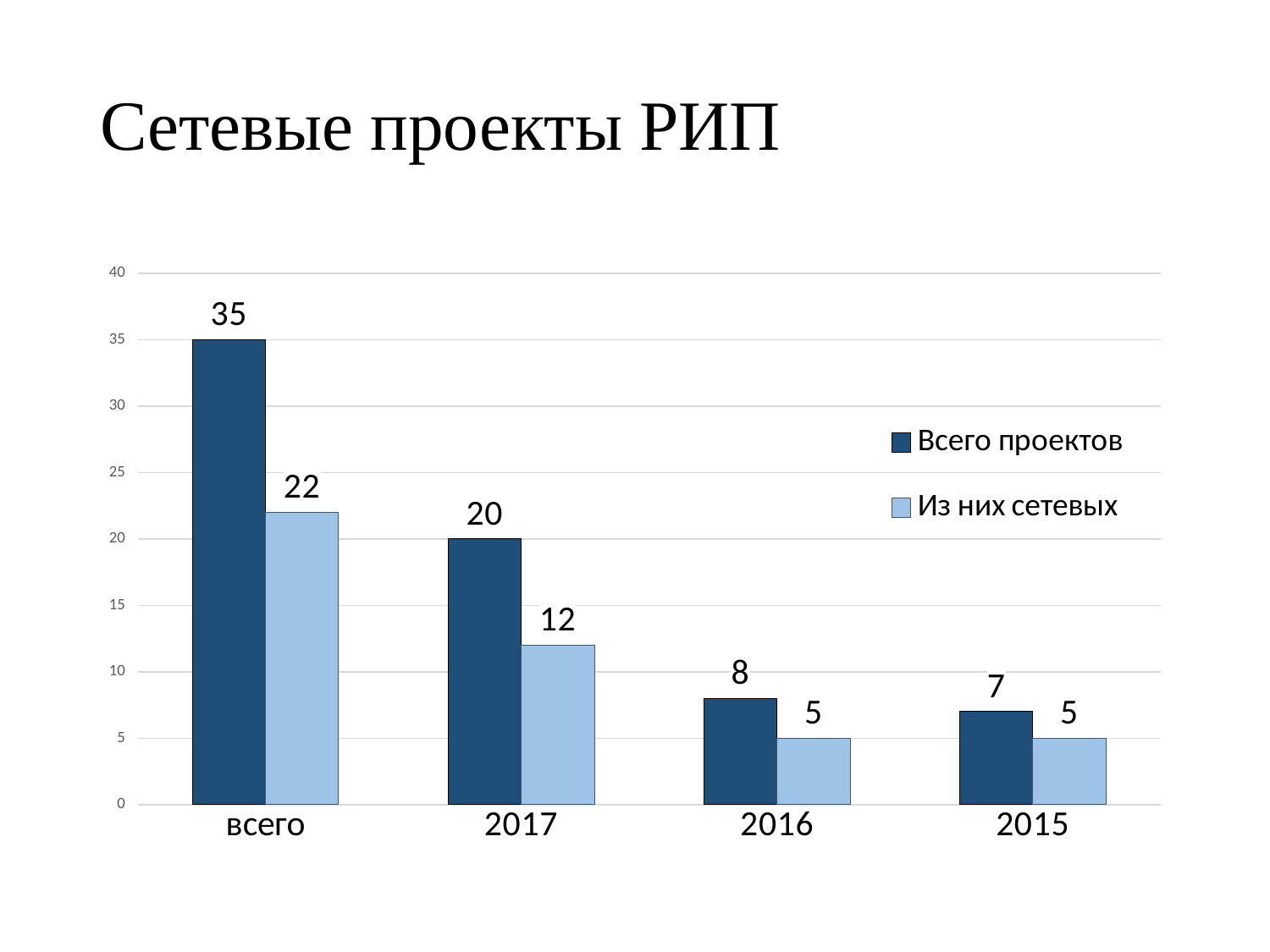
What is the value of "Всего проектов" for 2017? 20 What kind of chart is shown on the slide? bar chart What is the title of the slide? Сетевые проекты РИП What is the value of "Из них сетевых" for "всего"? 22 What is the difference between "Всего проектов" and "Из них сетевых" for 2017? 8 Which category has the lowest value for "Всего проектов"? 2015 Which is larger: "Из них сетевых" for 2017 or "Всего проектов" for 2016? Из них сетевых for 2017 What is the difference between "Всего проектов" for 2016 and for 2015? 1 What is the value of "Из них сетевых" for 2016? 5 How many categories are shown on the x axis? 4 How many series does the legend list? 2 Which category has the highest value for "Всего проектов"? всего